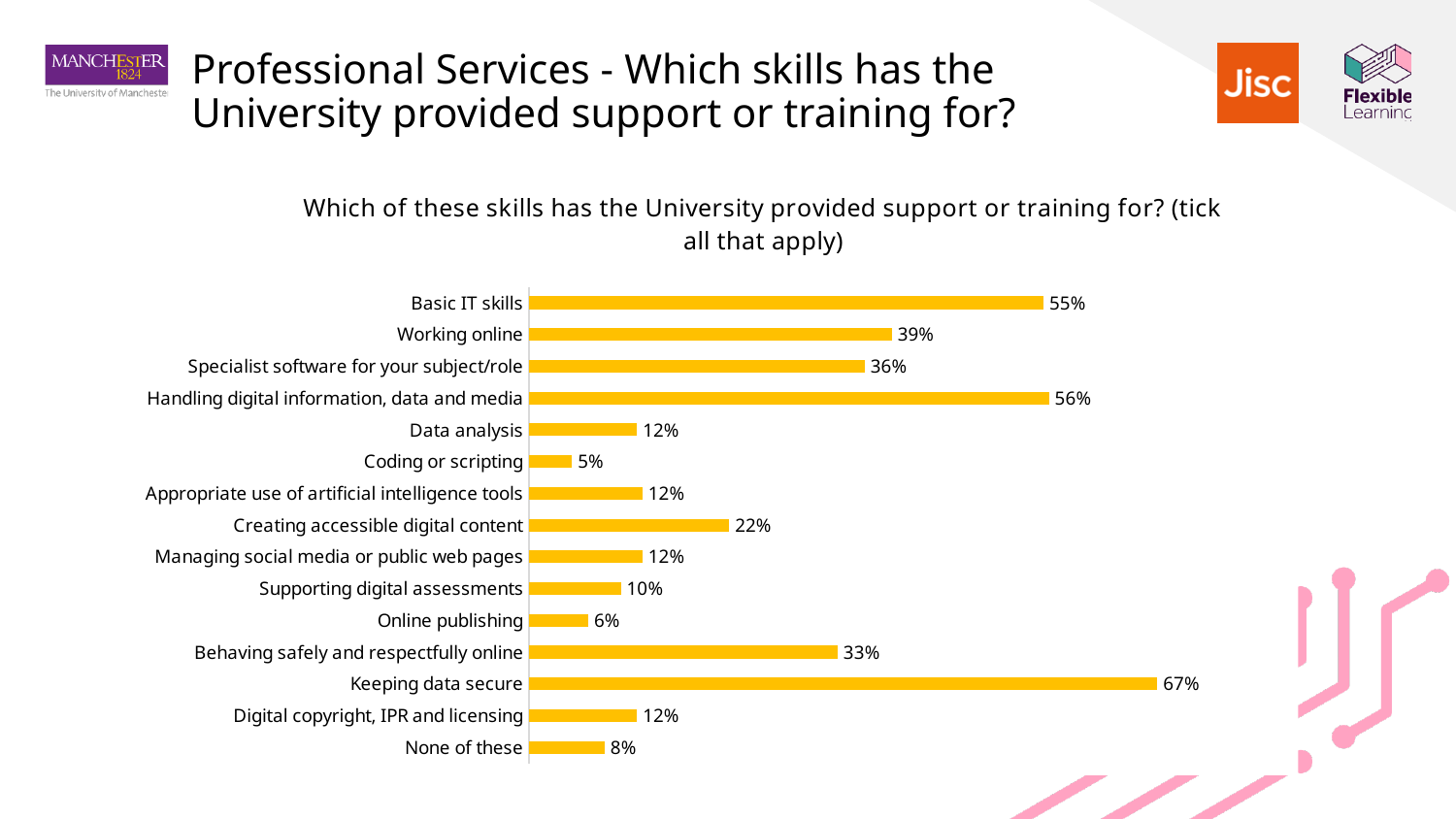
Which is larger, the value for Behaving safely and respectfully online or the value for Specialist software for your subject/role? Behaving safely and respectfully online What percentage is shown for Keeping data secure? 67% How many categories are shown in the chart? 15 What is the title of the chart? Which of these skills has the University provided support or training for? (tick all that apply) Which category has the lowest value? Coding or scripting What is the difference between the values for Basic IT skills and Working online? 16% Which category has the highest value? Keeping data secure What kind of chart is shown on the slide? Bar chart What percentage is shown for None of these? 8% What is the difference between the values for Keeping data secure and Handling digital information, data and media? 11% What percentage is shown for Coding or scripting? 5% What percentage is shown for Creating accessible digital content? 22%